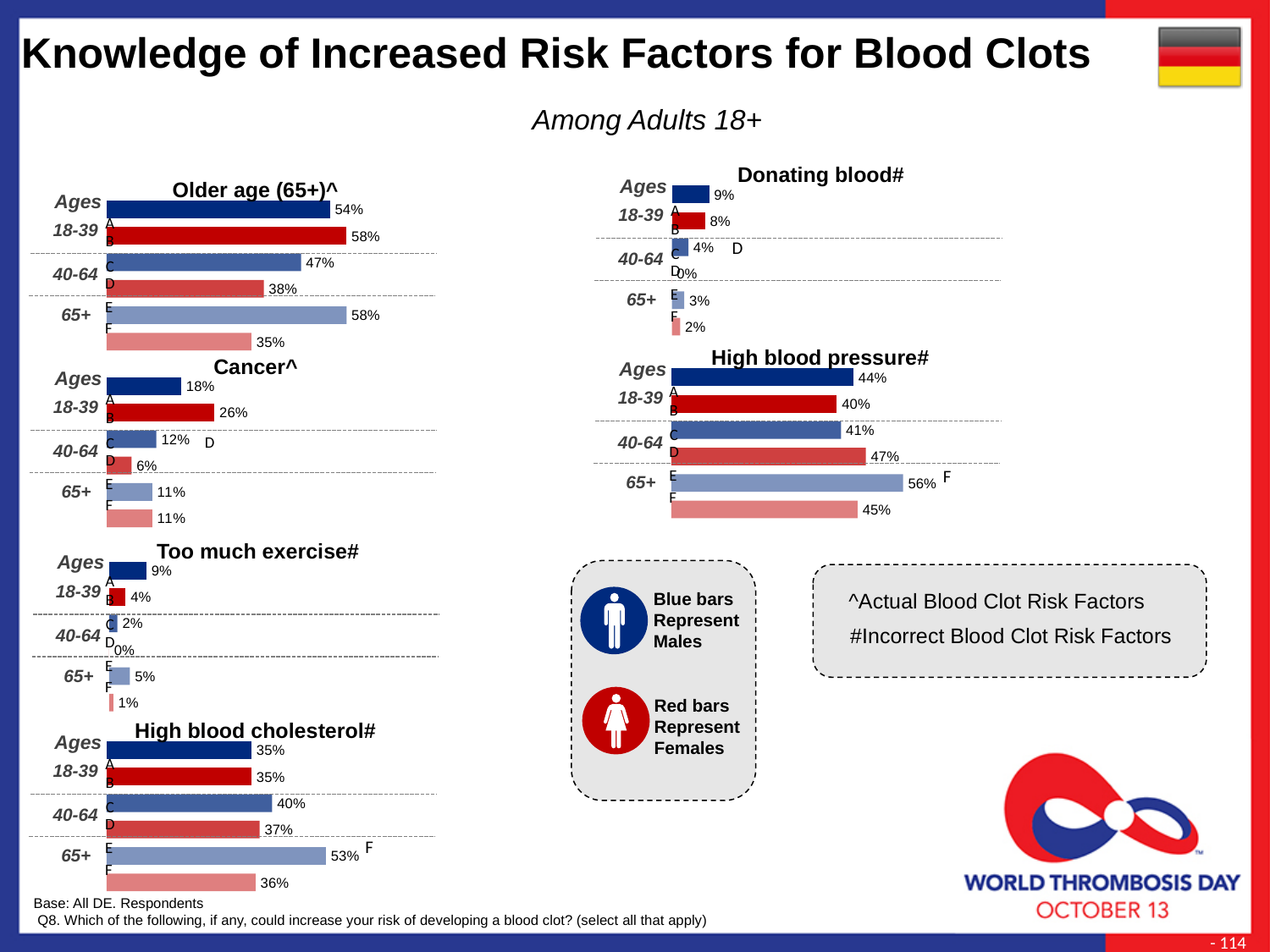
In the 'Cancer^' chart, what is the value for females aged 18-39? 26% In the 'Older age (65+)^' chart, what is the value for males aged 40-64? 47% In the 'High blood cholesterol#' chart, what is the difference between males and females aged 65+? 17% How many charts are shown on the slide? 6 In the 'Older age (65+)^' chart, what is the difference between males and females aged 65+? 23% In the 'High blood pressure#' chart, which is larger: males aged 65+ or females aged 65+? Males aged 65+ In the 'Donating blood#' chart, what is the value for males aged 18-39? 9% In the 'Too much exercise#' chart, which group has the lowest value? Females 40-64 In the 'Older age (65+)^' chart, what percentage of females aged 18-39 identified older age as a risk factor? 58% In the 'High blood pressure#' chart, what is the value for females aged 40-64? 47% In the 'Cancer^' chart, which group has the highest value? Females 18-39 What type of chart is used for 'High blood cholesterol#'? Bar chart